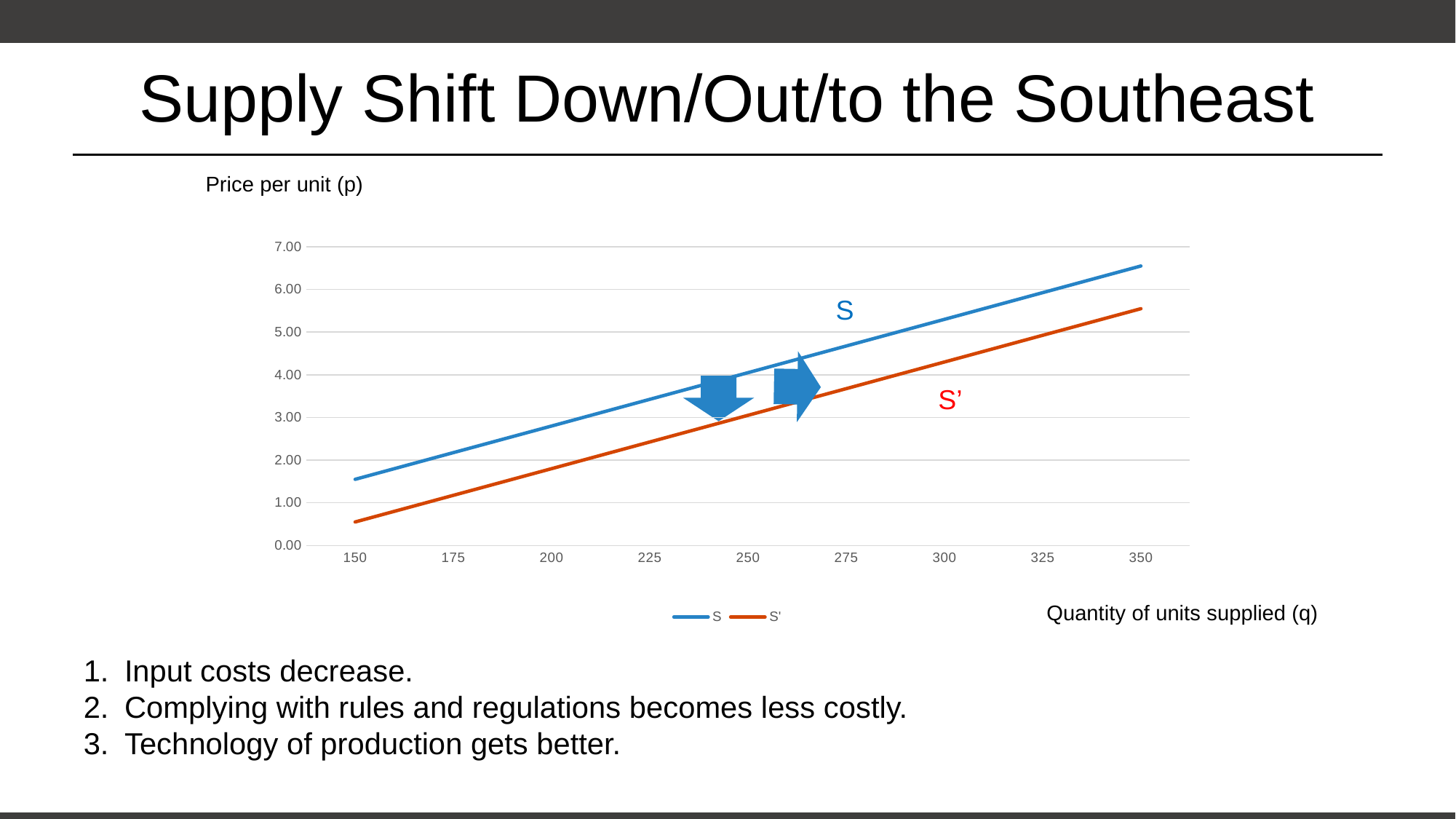
At a quantity of 350, which line has the higher price, S or S'? S Is the value of the S line at a quantity of 150 greater or less than 2.00? less At a quantity of 150, which line has the lower price, S or S'? S' What kind of chart is shown on the slide? line chart Is the value of the S' line at a quantity of 150 greater or less than 1.00? less What colour is the S' line? red Is the value of the S line at a quantity of 350 greater or less than 6.00? greater Do the values of the S' line rise or fall as quantity increases along the x axis? rise What are the names of the two series in the legend? S and S' Do the values of the S line rise or fall as quantity increases along the x axis? rise How many series does the legend list? 2